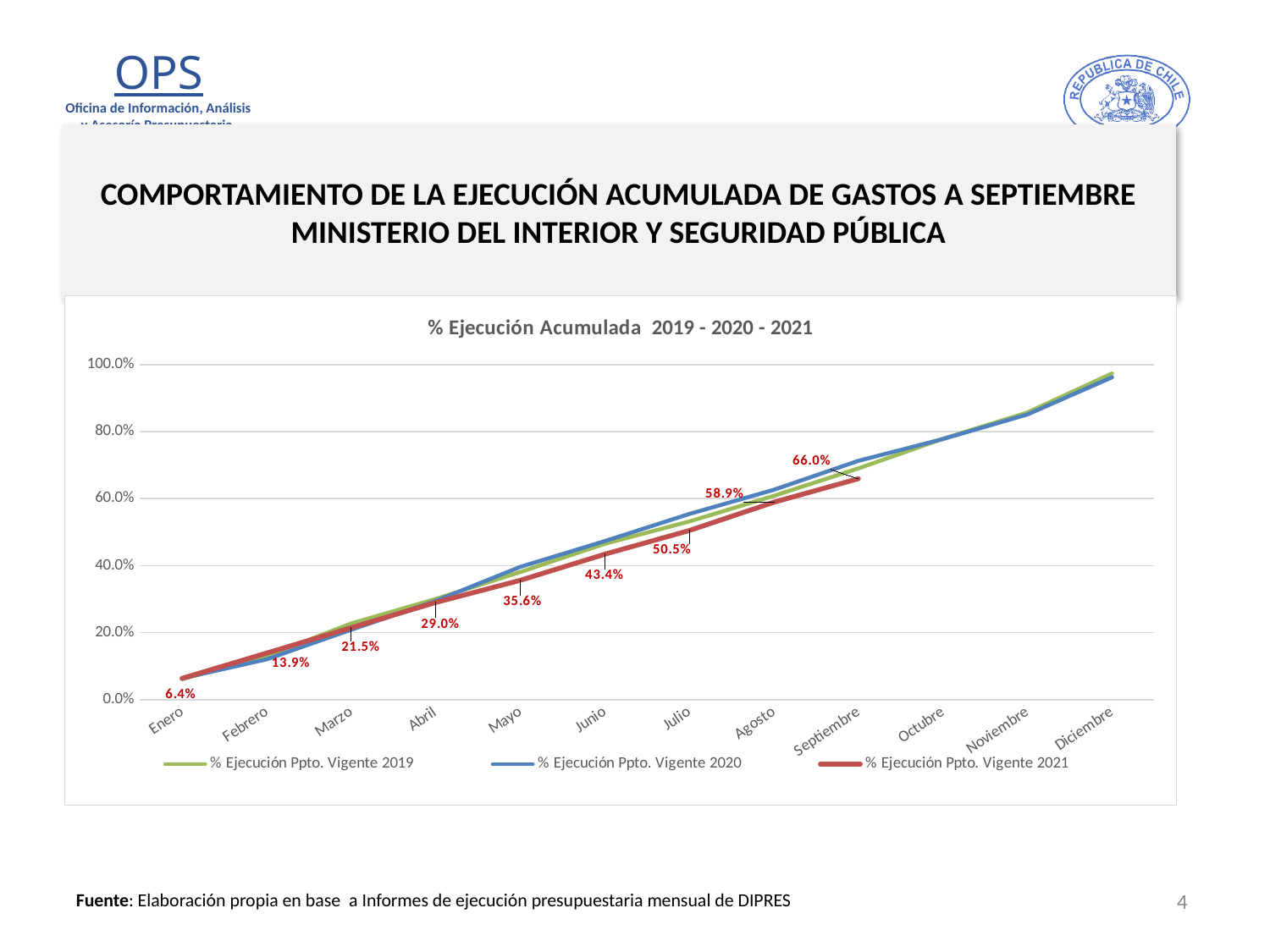
By how many percentage points does the 2021 series increase from Agosto to Septiembre? 7.1 How many months are shown on the x axis? 12 What kind of chart is shown on the slide? Line chart What is the title of the chart? % Ejecución Acumulada 2019 - 2020 - 2021 How many series does the legend list? 3 What is the value of % Ejecución Ppto. Vigente 2021 in Enero? 6.4% What is the value of % Ejecución Ppto. Vigente 2021 in Septiembre? 66.0% What is the value of % Ejecución Ppto. Vigente 2021 in Mayo? 35.6% Is the value for % Ejecución Ppto. Vigente 2019 in Marzo greater or less than 40.0%? less What is the difference between the 2021 values for Julio and Junio? 7.1 Is the value for % Ejecución Ppto. Vigente 2020 in Diciembre greater or less than 80.0%? greater Do the values of the 2021 series rise or fall from Enero to Septiembre? Rise